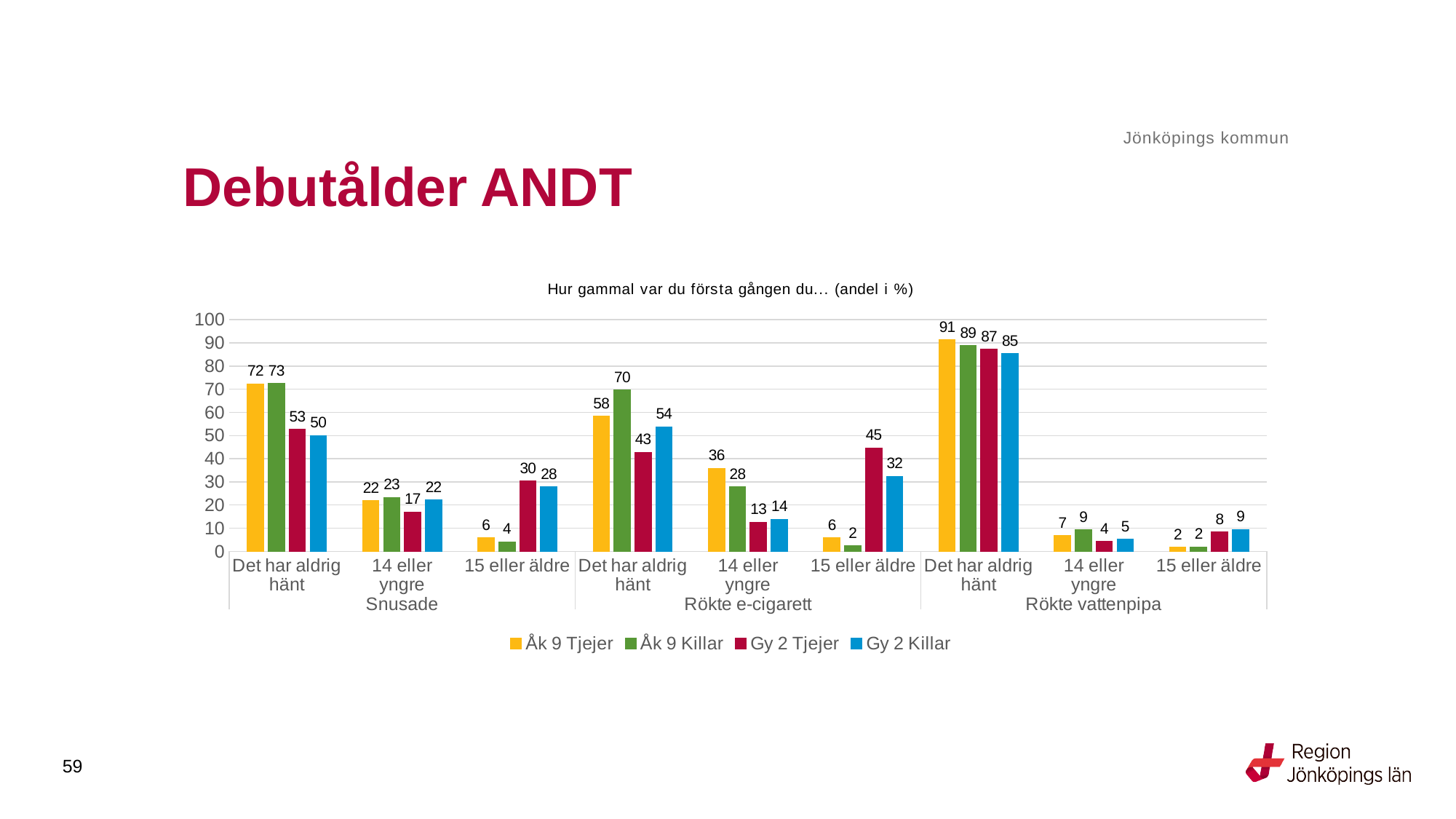
What kind of chart is shown on the slide? Bar chart Which is larger in the '14 eller yngre' category under Rökte e-cigarett: Åk 9 Tjejer or Gy 2 Killar? Åk 9 Tjejer Which series has the highest value in the 'Det har aldrig hänt' category under Rökte e-cigarett? Åk 9 Killar What is the value for Gy 2 Tjejer in the '15 eller äldre' category under Rökte e-cigarett? 45 Which series has the lowest value in the '15 eller äldre' category under Snusade? Åk 9 Killar What is the value for Åk 9 Tjejer in the 'Det har aldrig hänt' category under Snusade? 72 What is the title of the chart? Hur gammal var du första gången du… (andel i %) Is the value for Gy 2 Tjejer in the 'Det har aldrig hänt' category under Rökte e-cigarett greater or less than 50? less How many category groups are shown along the x axis? 9 What is the difference between Åk 9 Tjejer and Gy 2 Tjejer in the 'Det har aldrig hänt' category under Snusade? 19 What is the value for Gy 2 Killar in the 'Det har aldrig hänt' category under Rökte vattenpipa? 85 How many series does the legend list? 4